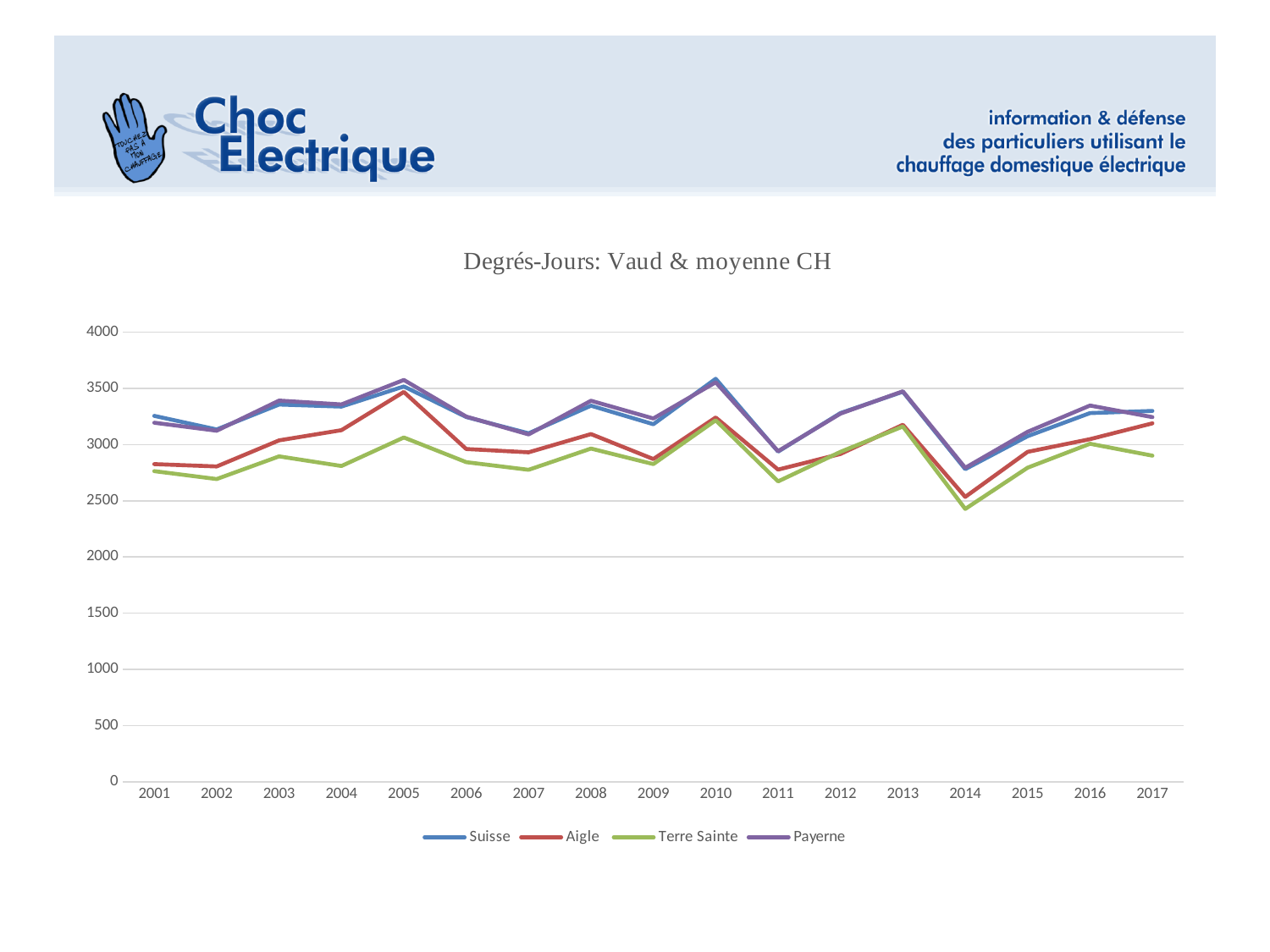
Is the value for Aigle in 2017 greater or less than 3000? greater In which year is the value for Terre Sainte lowest? 2014 Is the value for Terre Sainte in 2014 greater or less than 2500? less In 2005, which is larger: the value for Payerne or the value for Terre Sainte? Payerne What kind of chart is shown on the slide? Line chart Is the value for Terre Sainte in 2011 greater or less than 3000? less In which year is the value for Aigle lowest? 2014 Which series is shown in green in the legend? Terre Sainte How many series does the legend list? 4 Does the value for Aigle rise or fall from 2014 to 2017? rise How many years are plotted along the x axis? 17 What is the title of the chart? Degrés-Jours: Vaud & moyenne CH